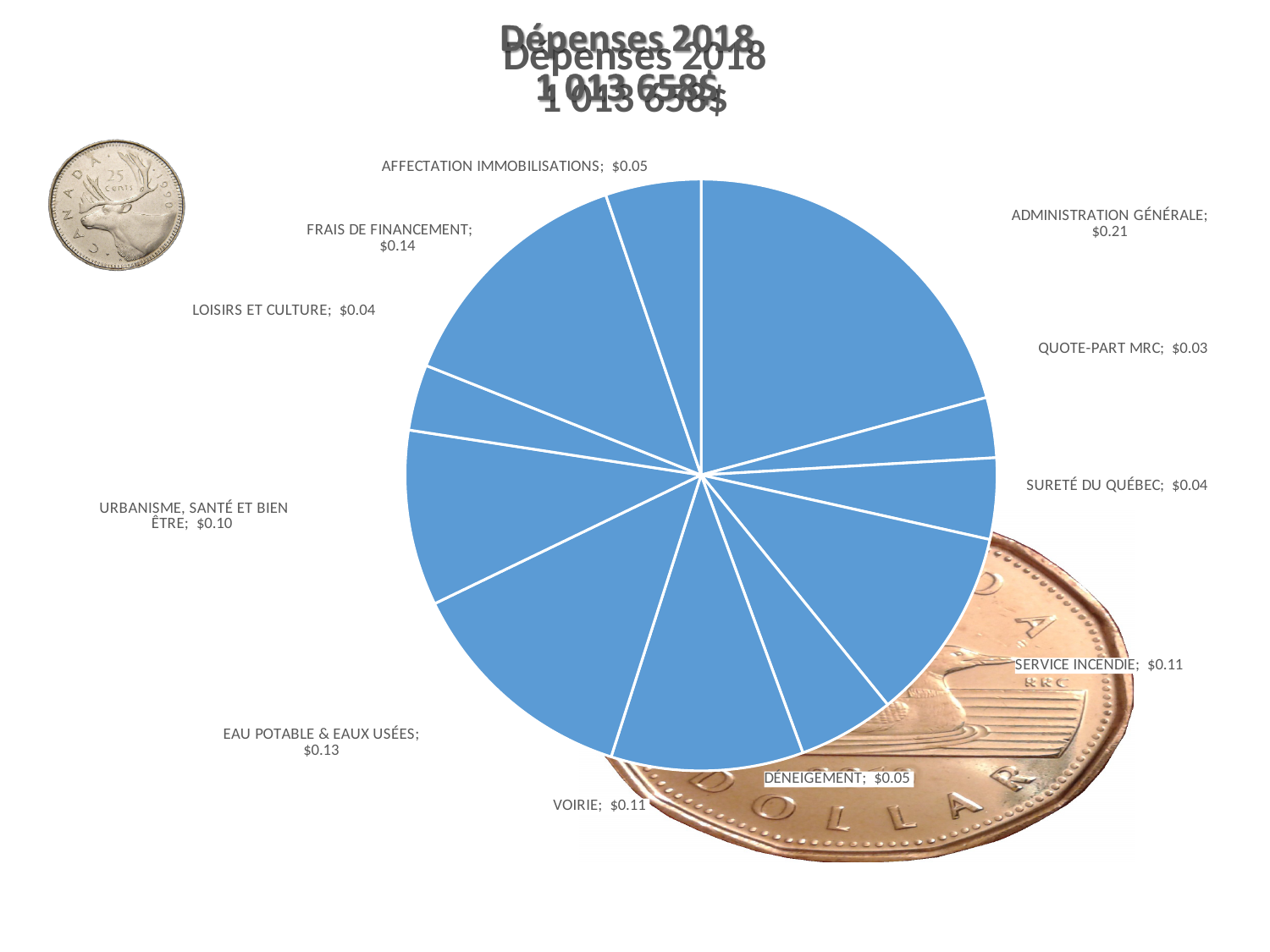
Which category has the largest slice of the pie? ADMINISTRATION GÉNÉRALE How many categories are shown in the pie chart? 11 What kind of chart is shown on the slide? Pie chart What is the value shown for QUOTE-PART MRC? $0.03 What is the title of the chart? Dépenses 2018 1 013 658$ What is the value shown for ADMINISTRATION GÉNÉRALE? $0.21 What is the value shown for EAU POTABLE & EAUX USÉES? $0.13 Which is larger, the value for FRAIS DE FINANCEMENT or the value for EAU POTABLE & EAUX USÉES? FRAIS DE FINANCEMENT What is the difference between the values for ADMINISTRATION GÉNÉRALE and FRAIS DE FINANCEMENT? $0.07 What colour are the slices of the pie chart? Blue Which category has the smallest slice of the pie? QUOTE-PART MRC What is the value shown for FRAIS DE FINANCEMENT? $0.14